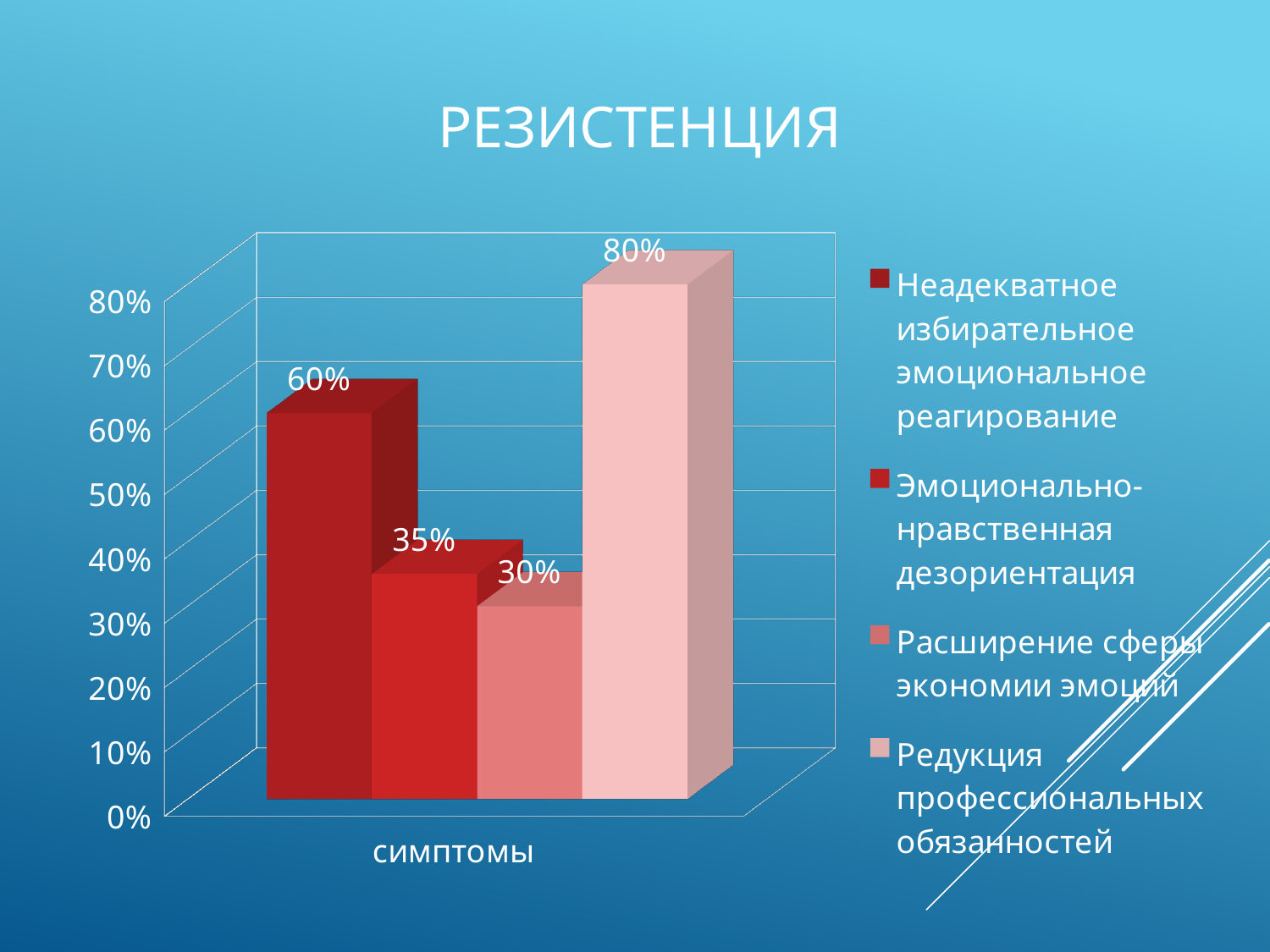
What is the value for Эмоционально-нравственная дезориентация? 35% Which series has the highest value? Редукция профессиональных обязанностей What is the label on the x axis of the chart? симптомы Which series has the lowest value? Расширение сферы экономии эмоций Which is larger: the value for Эмоционально-нравственная дезориентация or the value for Расширение сферы экономии эмоций? Эмоционально-нравственная дезориентация What is the value for Редукция профессиональных обязанностей? 80% What is the difference between the values for Редукция профессиональных обязанностей and Неадекватное избирательное эмоциональное реагирование? 20% What kind of chart is shown on the slide? Bar chart What is the title of the slide? РЕЗИСТЕНЦИЯ What is the value for Неадекватное избирательное эмоциональное реагирование? 60% How many series does the legend list? 4 What is the value for Расширение сферы экономии эмоций? 30%